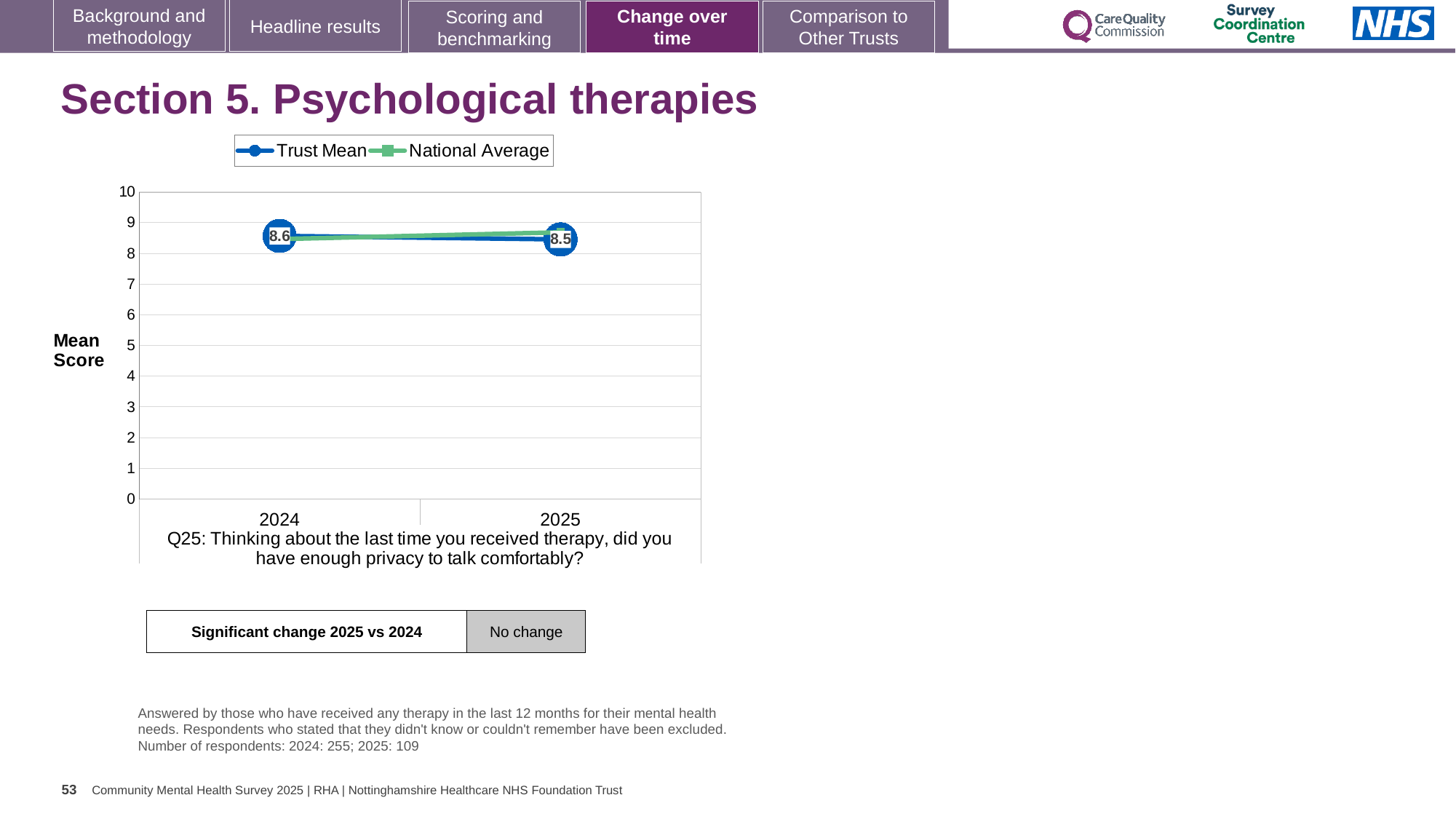
What is the Trust Mean for 2025? 8.5 What kind of chart is shown on the slide? line chart In which year is the Trust Mean higher? 2024 In which year is the Trust Mean lower? 2025 Is the National Average value for 2025 greater or less than 8? greater Is the Trust Mean value for 2024 greater or less than 9? less Does the Trust Mean rise or fall from 2024 to 2025? fall Which is larger, the Trust Mean for 2024 or the Trust Mean for 2025? 2024 How many series does the legend list? 2 How many years are shown on the x axis of the chart? 2 What is the Trust Mean for 2024? 8.6 What is the difference between the Trust Mean in 2024 and in 2025? 0.1